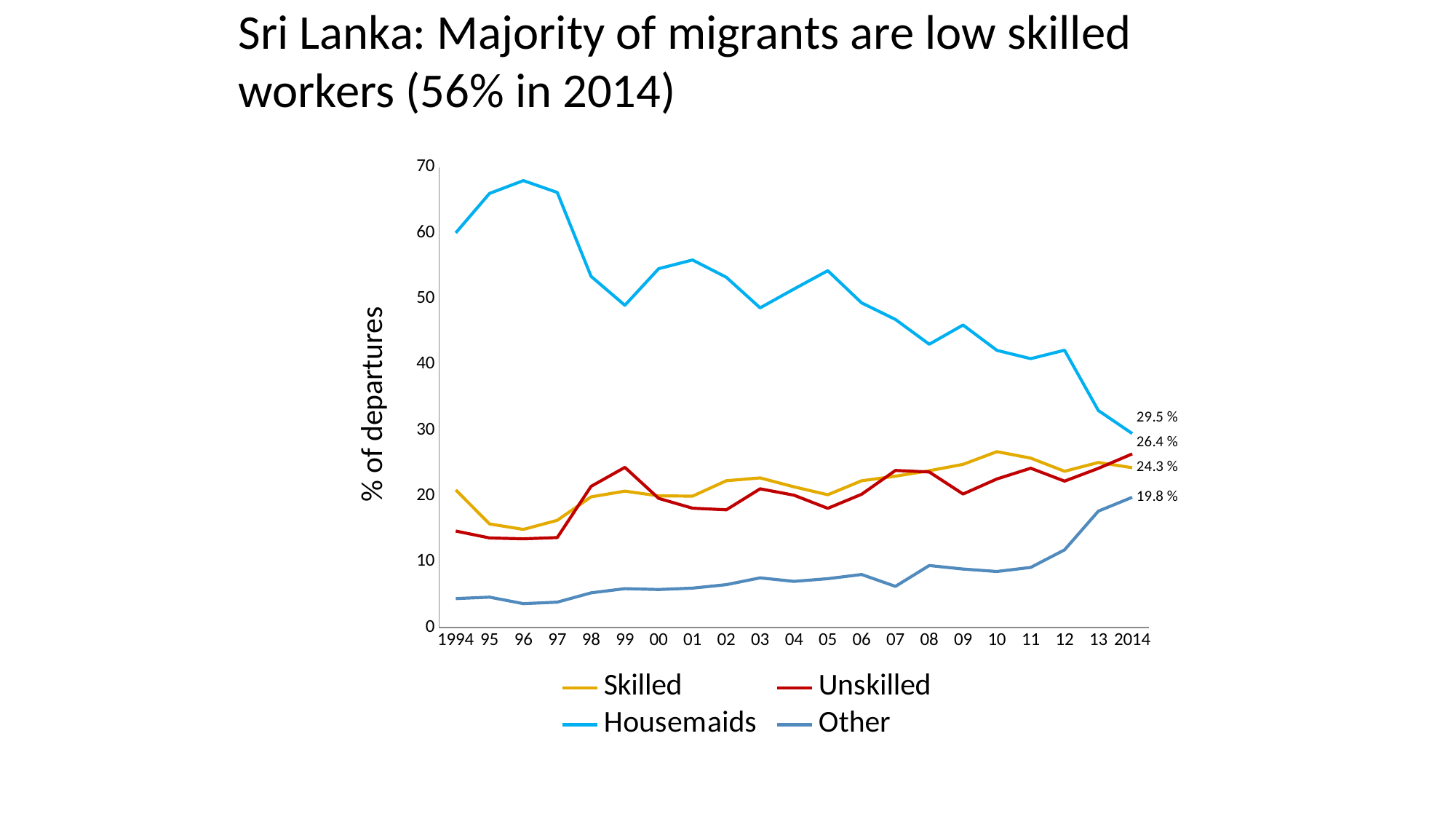
Is the value for Housemaids in 1996 greater or less than 60? greater Does the Housemaids series generally rise or fall from 1994 to 2014? fall What is the value for Unskilled in 2014? 26.4 % Which series has the highest value in 2014? Housemaids What is the difference between the Housemaids and Other values in 2014? 9.7 % What is the value for Other in 2014? 19.8 % What kind of chart is shown on the slide? line chart Which series has the lowest value in 2014? Other How many series does the legend list? 4 What is the value for Housemaids in 2014? 29.5 % Is the value for Other in 1994 greater or less than 10? less What is the value for Skilled in 2014? 24.3 %